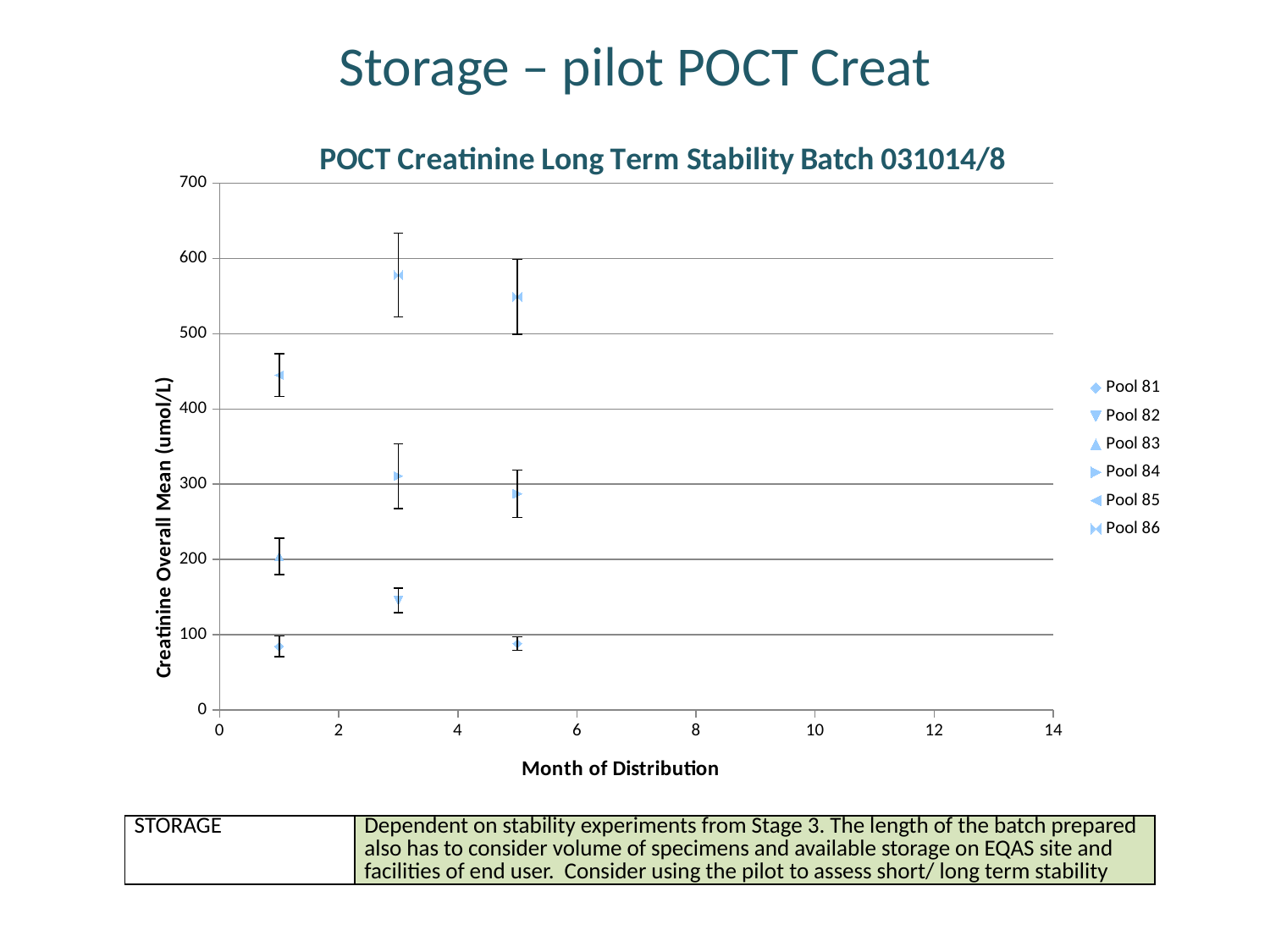
How many series does the legend list? 6 Is the highest point plotted at month 3 greater or less than 500? greater What is the title of the chart? POCT Creatinine Long Term Stability Batch 031014/8 Is the lowest point plotted at month 5 greater or less than 200? less Is the highest point plotted at month 5 greater or less than 600? less At how many distinct months along the x axis are data points plotted? 3 Which is larger: the highest point at month 3 or the highest point at month 1? the highest point at month 3 What kind of chart is shown on the slide? scatter chart What is the label on the vertical axis of the chart? Creatinine Overall Mean (umol/L)